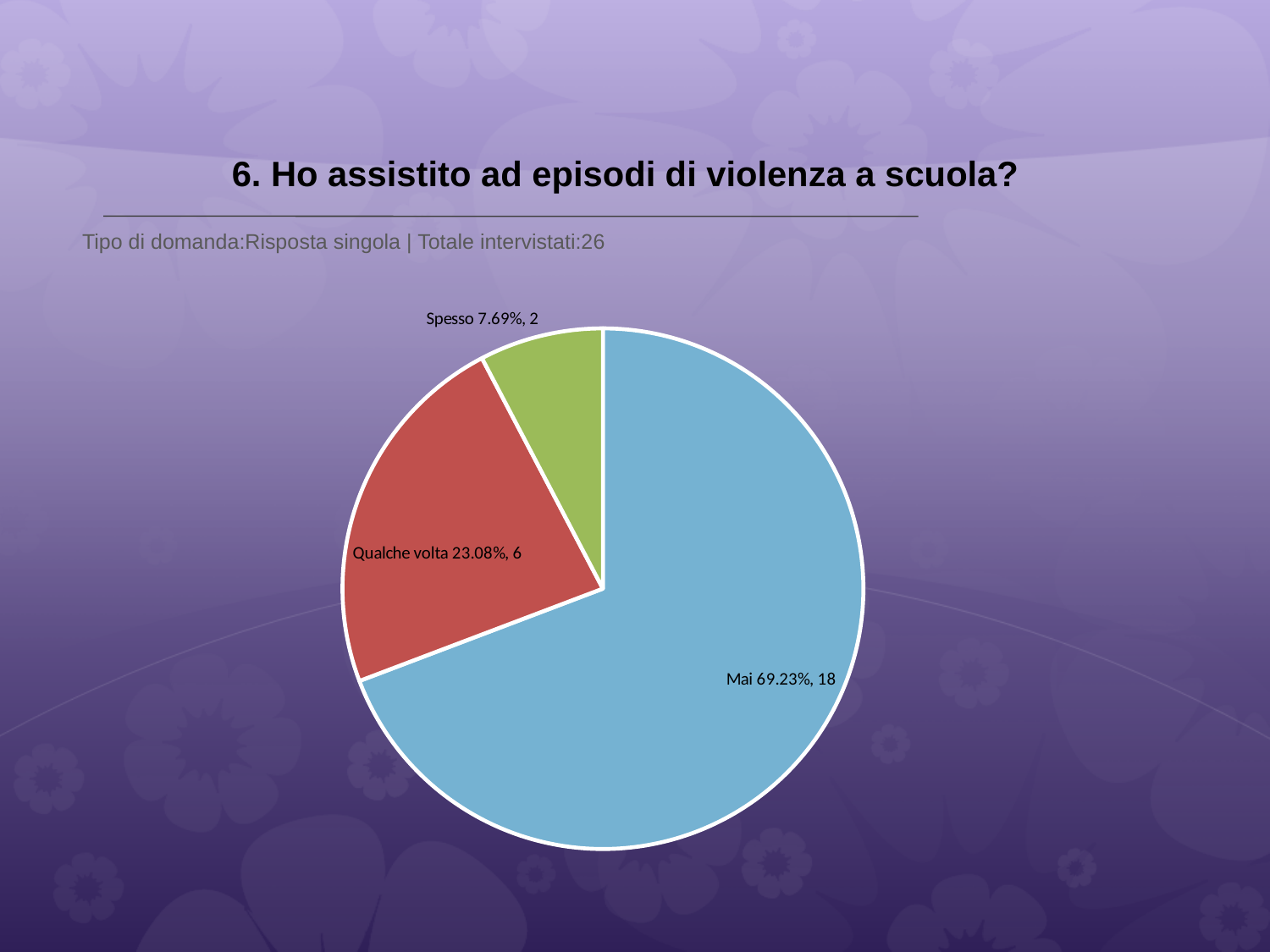
What kind of chart is shown on the slide? pie chart What colour is the 'Mai' slice? blue How many respondents answered 'Spesso'? 2 Which answer has the smallest slice of the pie? Spesso Which has more respondents, 'Qualche volta' or 'Spesso'? Qualche volta What is the difference in number of respondents between 'Mai' and 'Qualche volta'? 12 What percentage share does the 'Qualche volta' slice have? 23.08% What percentage share does the 'Mai' slice have? 69.23% How many respondents answered 'Qualche volta'? 6 Which answer has the largest slice of the pie? Mai How many slices does the pie chart have? 3 What is the total number of respondents across all slices? 26